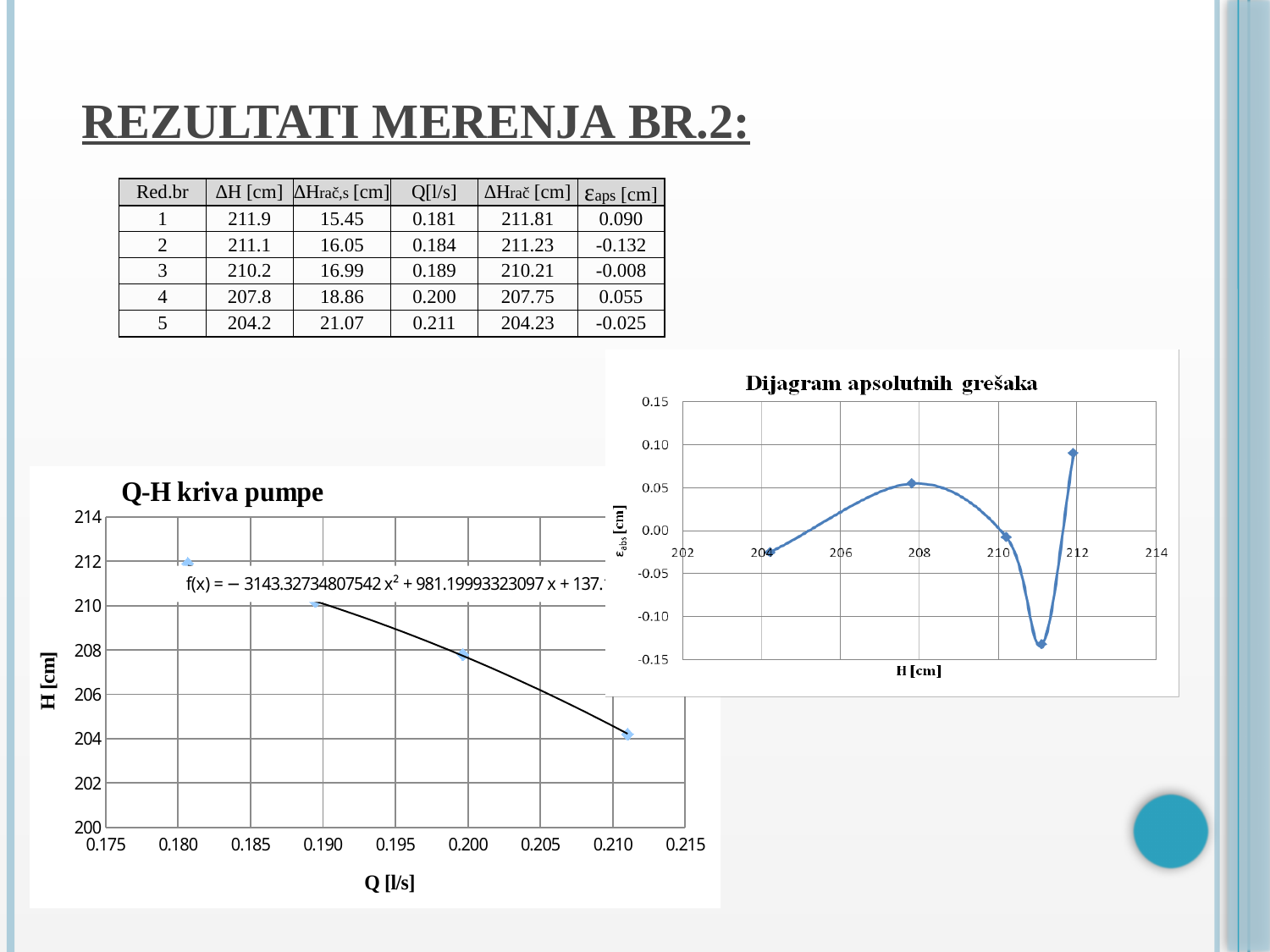
On the "Q-H kriva pumpe" chart, is the H value of the point near Q = 0.180 greater or less than 210? greater How many data points are plotted on the "Dijagram apsolutnih grešaka" chart? 5 On the "Dijagram apsolutnih grešaka" chart, is the lowest point greater or less than -0.10? less On the "Q-H kriva pumpe" chart, does H rise or fall as Q increases along the x axis? fall On the "Dijagram apsolutnih grešaka" chart, is the highest point greater or less than 0.05? greater What kind of chart is the "Q-H kriva pumpe" chart? scatter chart with a fitted curve What is the x-axis label of the "Dijagram apsolutnih grešaka" chart? H [cm] How many data points are plotted on the "Q-H kriva pumpe" chart? 5 What is the x-axis label of the "Q-H kriva pumpe" chart? Q [l/s] What kind of chart is the "Dijagram apsolutnih grešaka" chart? line chart with markers